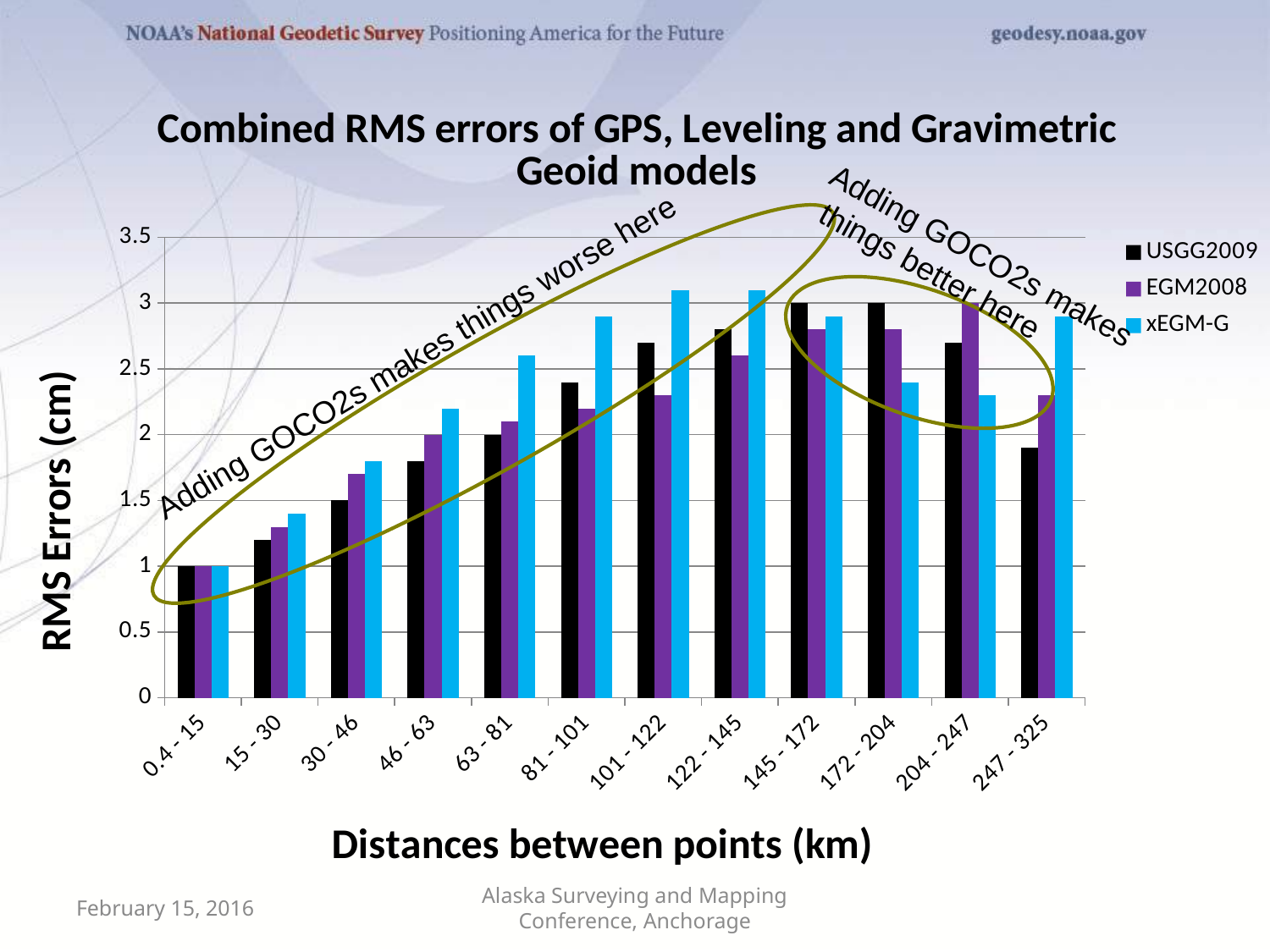
For the 204 - 247 km category, which is larger: EGM2008 or xEGM-G? EGM2008 What is the label of the y axis? RMS Errors (cm) Is the xEGM-G value for 204 - 247 km greater or less than 2.5? less Is the USGG2009 value for 15 - 30 km greater or less than 1.5? less For the 81 - 101 km category, which is larger: USGG2009 or xEGM-G? xEGM-G How many distance categories are shown on the x axis? 12 What kind of chart is shown on the slide? bar chart Is the xEGM-G value for 81 - 101 km greater or less than 2.5? greater What is the title of the chart? Combined RMS errors of GPS, Leveling and Gravimetric Geoid models What is the USGG2009 value for the 0.4 - 15 km category? 1 How many series does the legend list? 3 What is the USGG2009 value for the 145 - 172 km category? 3